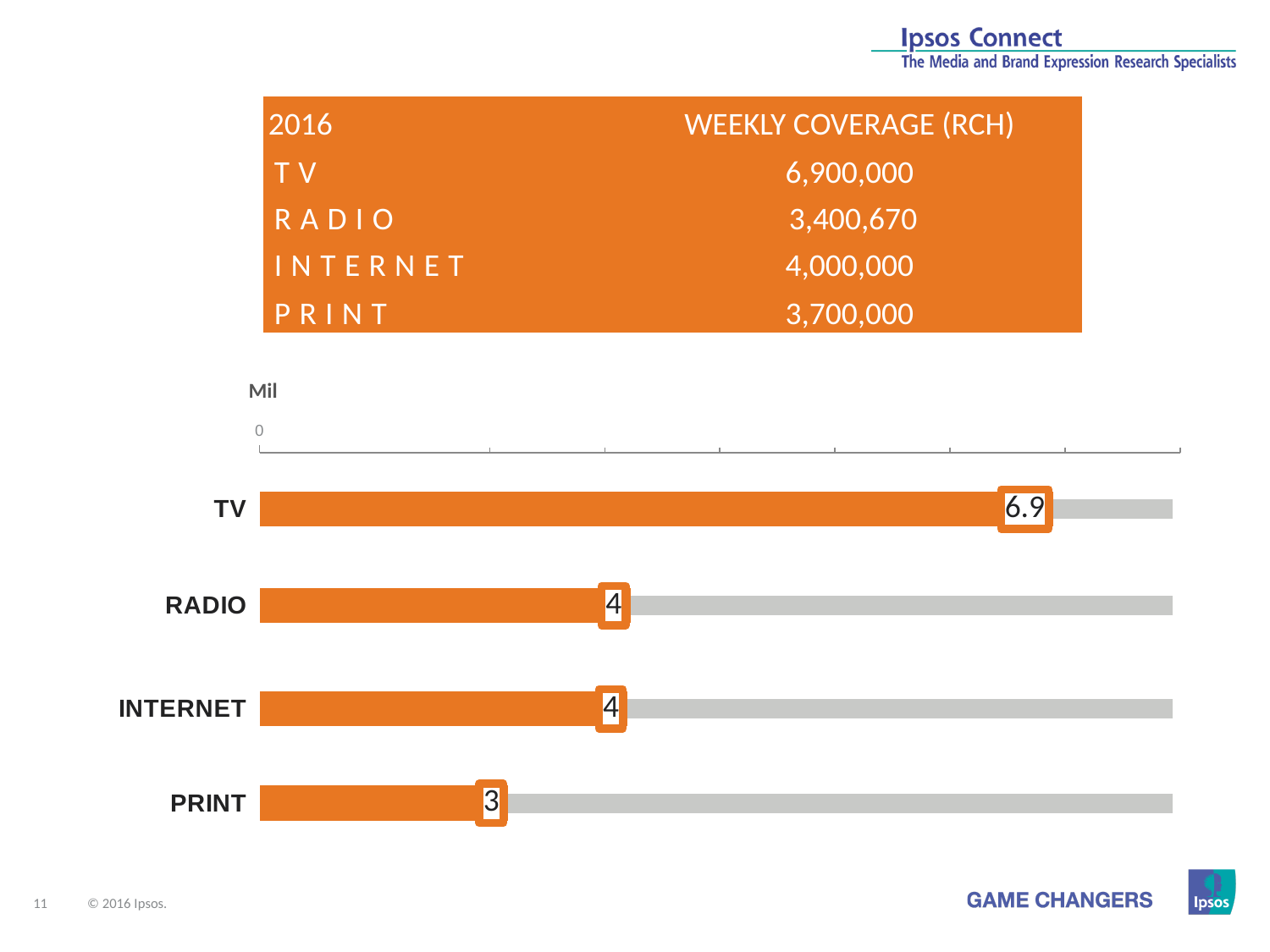
Which is larger in the bar chart, the value for TV or the value for INTERNET? TV Which category has the highest value in the bar chart? TV What is the value shown for TV in the bar chart? 6.9 What is the difference between the TV value and the PRINT value in the bar chart? 3.9 How many categories are plotted in the bar chart? 4 What is the value shown for RADIO in the bar chart? 4 What is the difference between the TV value and the RADIO value in the bar chart? 2.9 Which is larger in the bar chart, the value for PRINT or the value for RADIO? RADIO Which category has the lowest value in the bar chart? PRINT What kind of chart is shown on the slide? bar chart What is the value shown for INTERNET in the bar chart? 4 What is the value shown for PRINT in the bar chart? 3